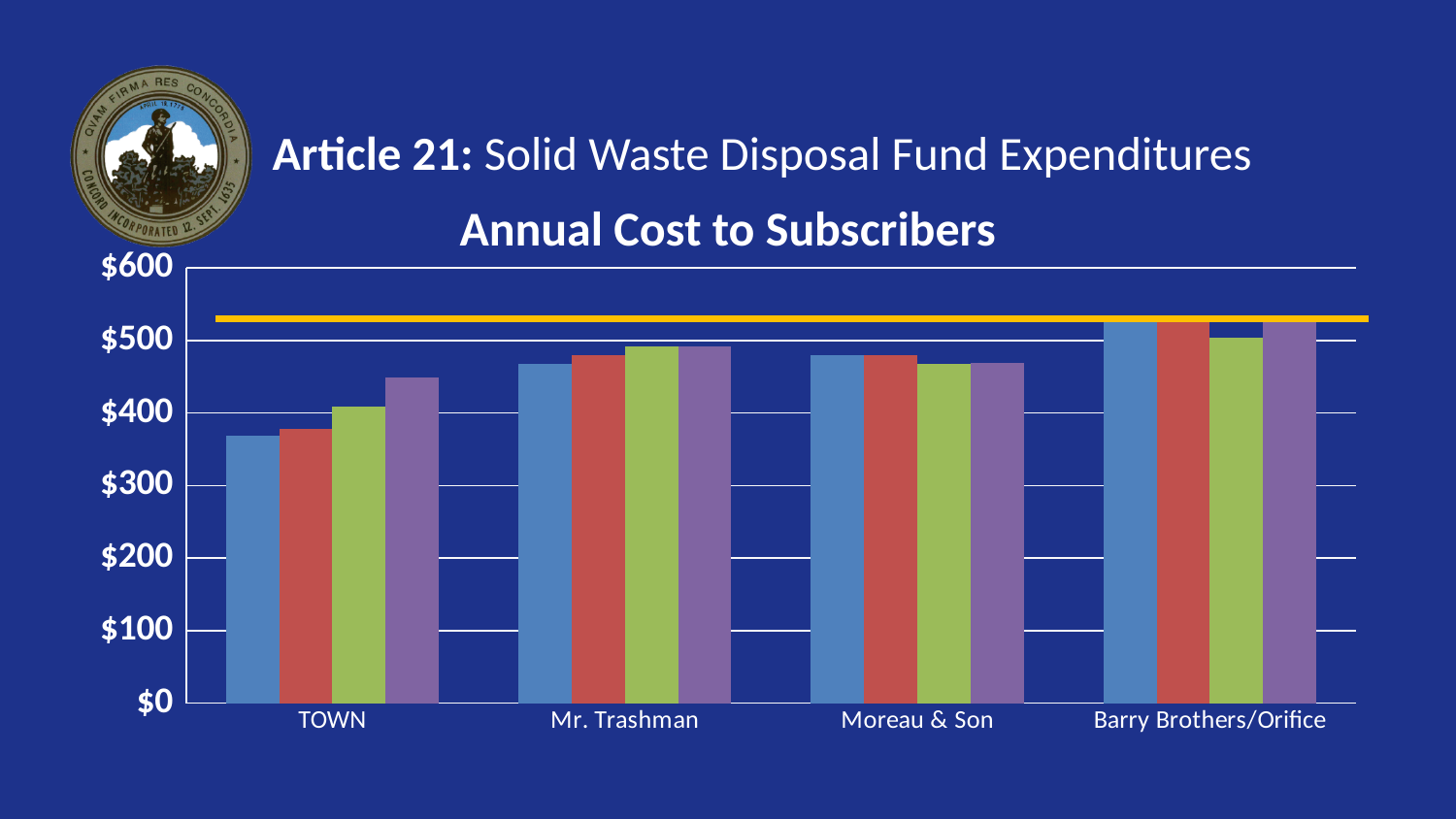
Which category has the lowest bars in the chart? TOWN Is the value of the blue bar for Barry Brothers/Orifice greater or less than $500? greater What kind of chart is shown on the slide? bar chart Is the value of the purple bar for TOWN greater or less than $400? greater Which category has the highest bars in the chart? Barry Brothers/Orifice How many bars are plotted for each category in the chart? 4 What is the title of the chart? Annual Cost to Subscribers Is the value of the blue bar for Moreau & Son greater or less than $500? less Which has the larger blue bar, TOWN or Mr. Trashman? Mr. Trashman How many categories are shown on the x axis of the chart? 4 What is the highest value shown on the y axis of the chart? $600